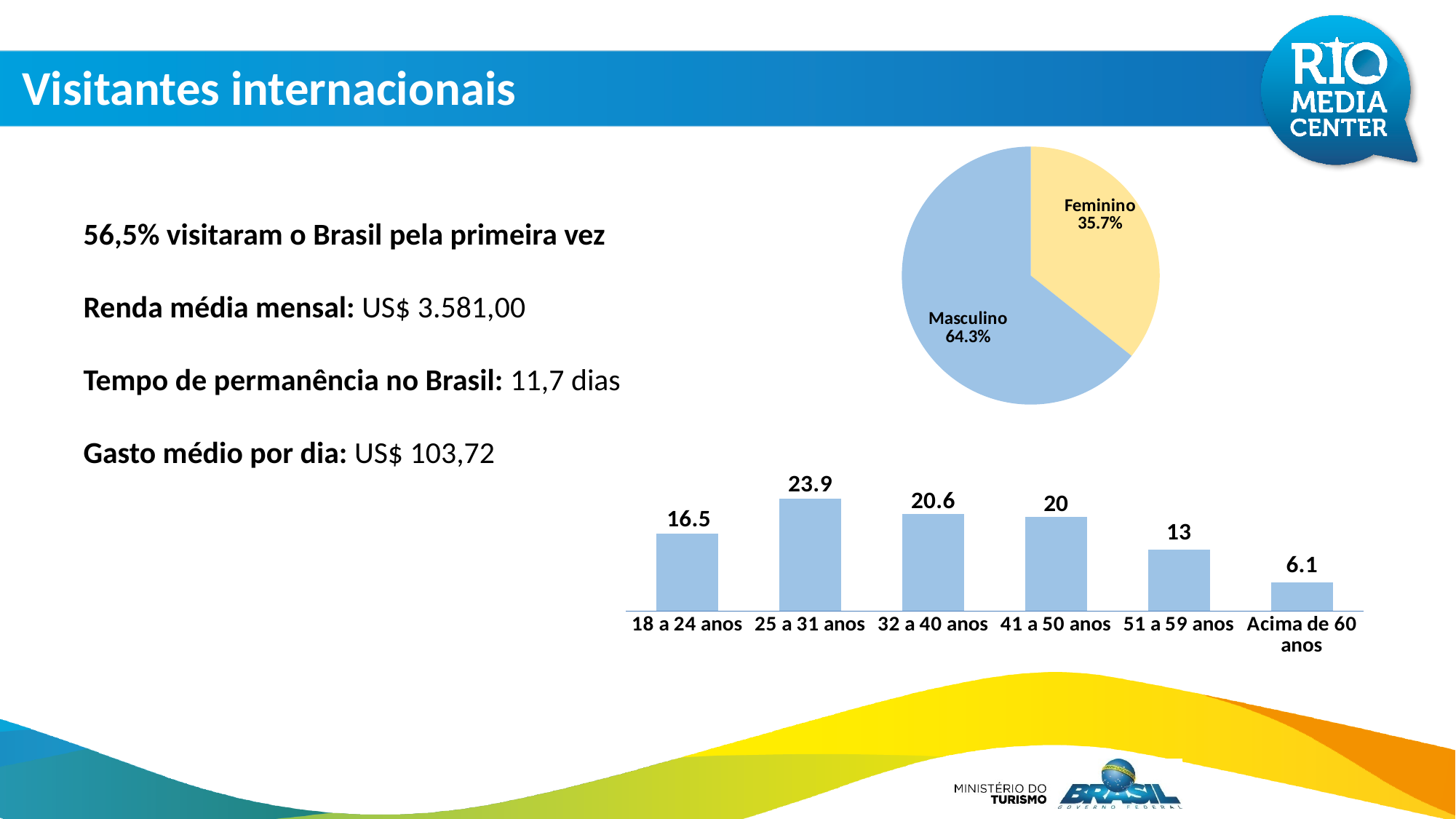
In the bar chart at the bottom right, what is the value for 25 a 31 anos? 23.9 In the bar chart at the bottom right, do the values rise or fall from 25 a 31 anos to Acima de 60 anos? fall In the bar chart at the bottom right, which age group has the highest value? 25 a 31 anos In the pie chart at the top right, how many slices are there? 2 In the bar chart at the bottom right, what is the value for Acima de 60 anos? 6.1 What kind of chart is the one at the bottom right showing age groups? bar chart In the bar chart at the bottom right, how many age groups are shown? 6 In the pie chart at the top right, what share is labelled for Feminino? 35.7% In the bar chart at the bottom right, what is the difference between the values for 32 a 40 anos and 51 a 59 anos? 7.6 In the pie chart at the top right, what share is labelled for Masculino? 64.3% In the pie chart at the top right, which slice is larger, Masculino or Feminino? Masculino In the bar chart at the bottom right, which age group has the lowest value? Acima de 60 anos